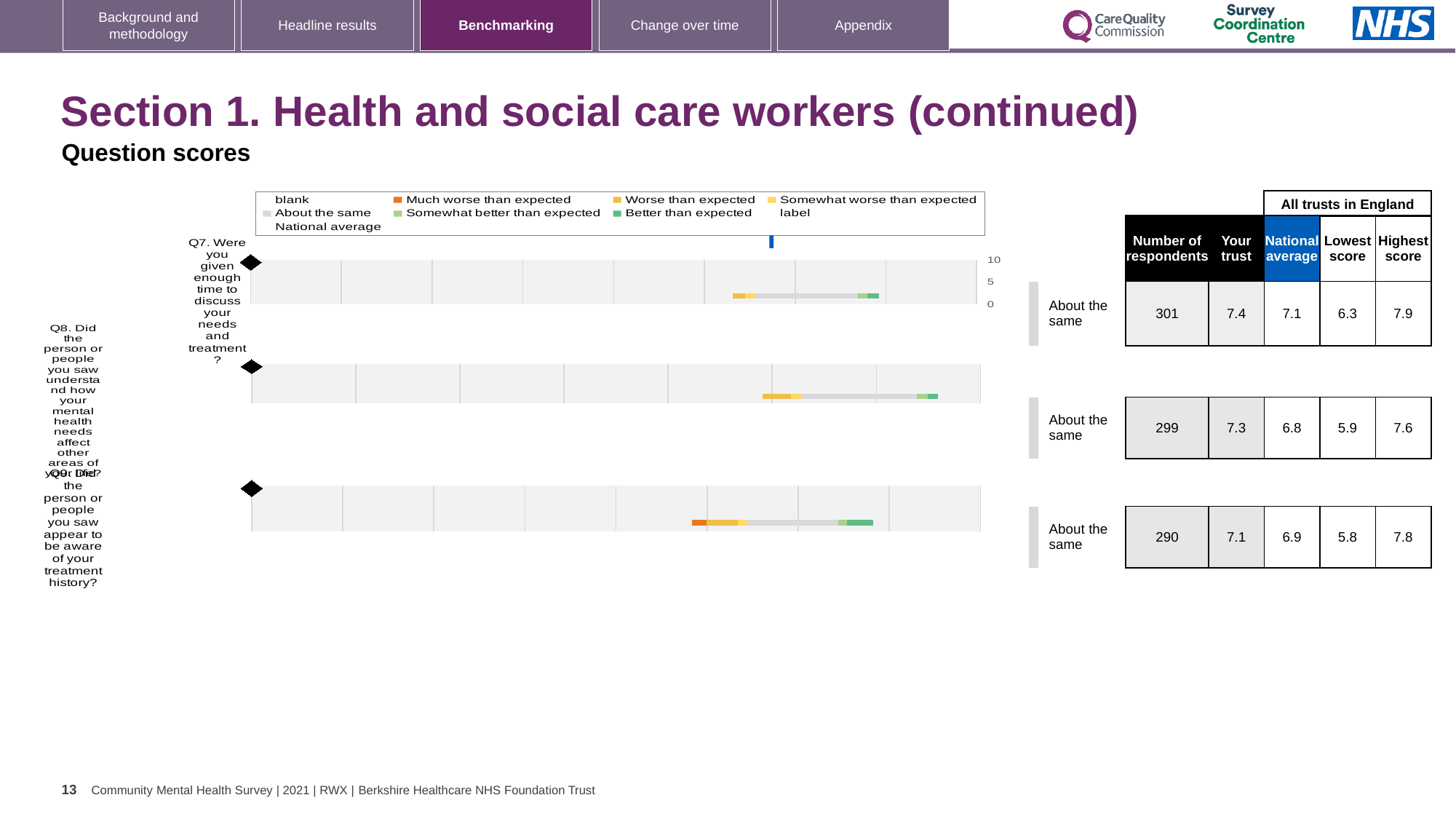
What benchmark category is shown for Q7, Q8 and Q9? About the same What is the 'Your trust' score for Q7 (Were you given enough time to discuss your needs and treatment?)? 7.4 What is the lowest score across all trusts in England for Q9? 5.8 For Q8, which is larger: the 'Your trust' score or the national average? Your trust What is the national average score for Q8 (Did the person or people you saw understand how your mental health needs affect other areas of your life?)? 6.8 Which question has the lowest national average score? Q8 Is the 'Your trust' score for Q9 greater or less than 5? greater How many respondents answered Q9 (Did the person or people you saw appear to be aware of your treatment history?)? 290 What kind of chart is used to show the question scores on this slide? bar chart What is the difference between the 'Your trust' score and the national average for Q7? 0.3 Which question has the highest 'Your trust' score? Q7 How many questions (Q7, Q8, Q9) are plotted on the slide? 3